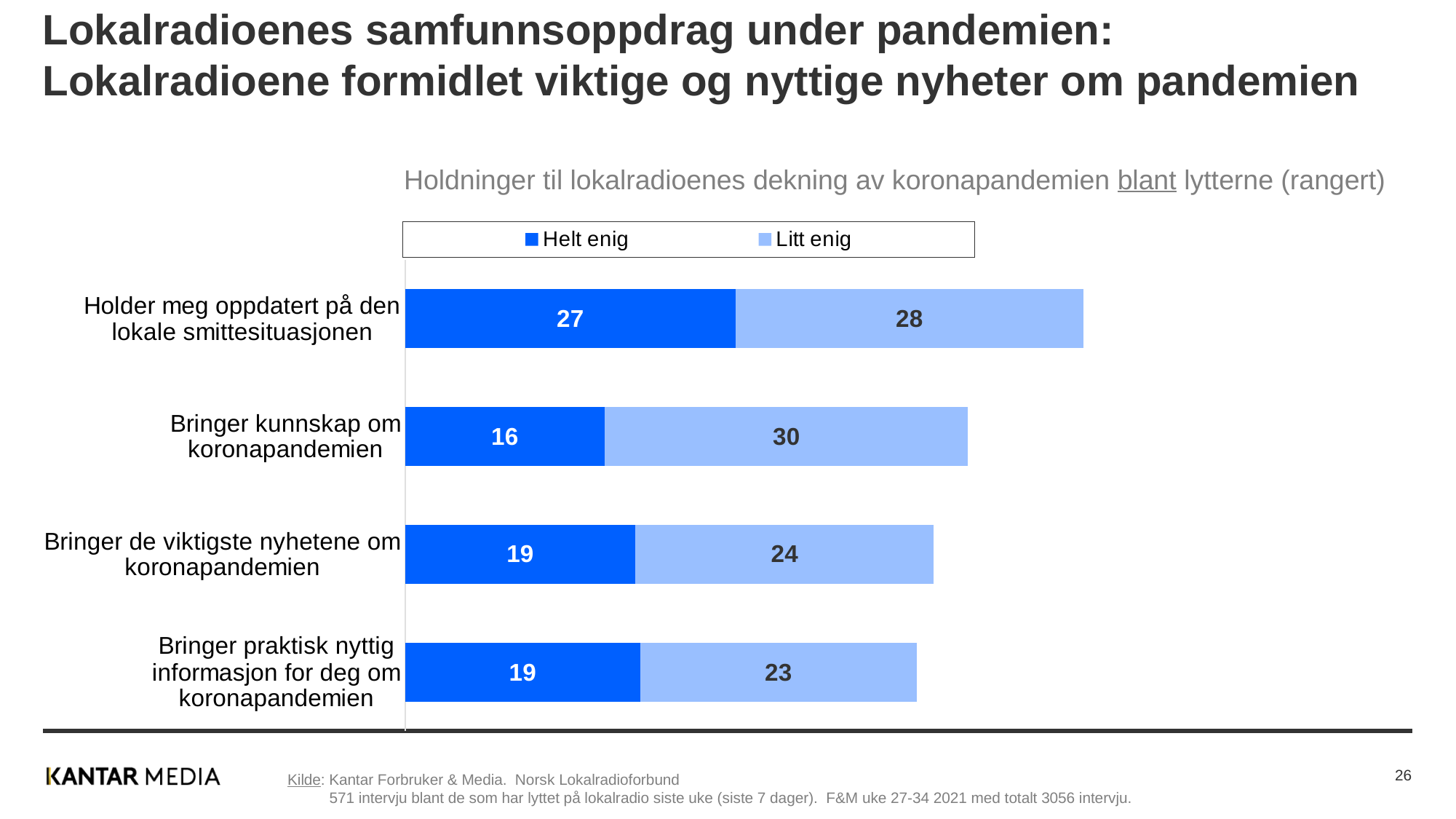
What is the "Litt enig" value for "Bringer praktisk nyttig informasjon for deg om koronapandemien"? 23 What is the difference between the "Litt enig" values for "Bringer kunnskap om koronapandemien" and "Bringer de viktigste nyhetene om koronapandemien"? 6 How many series does the legend list? 2 What is the total of the stacked bar for "Holder meg oppdatert på den lokale smittesituasjonen"? 55 What is the "Helt enig" value for "Holder meg oppdatert på den lokale smittesituasjonen"? 27 Which category has the lowest "Helt enig" value? Bringer kunnskap om koronapandemien How many categories are shown in the chart? 4 Which category has the highest "Helt enig" value? Holder meg oppdatert på den lokale smittesituasjonen What is the total of the stacked bar for "Bringer kunnskap om koronapandemien"? 46 Which is larger: the "Helt enig" value for "Holder meg oppdatert på den lokale smittesituasjonen" or the "Helt enig" value for "Bringer de viktigste nyhetene om koronapandemien"? Holder meg oppdatert på den lokale smittesituasjonen What is the "Litt enig" value for "Bringer kunnskap om koronapandemien"? 30 What kind of chart is shown on the slide? Stacked bar chart